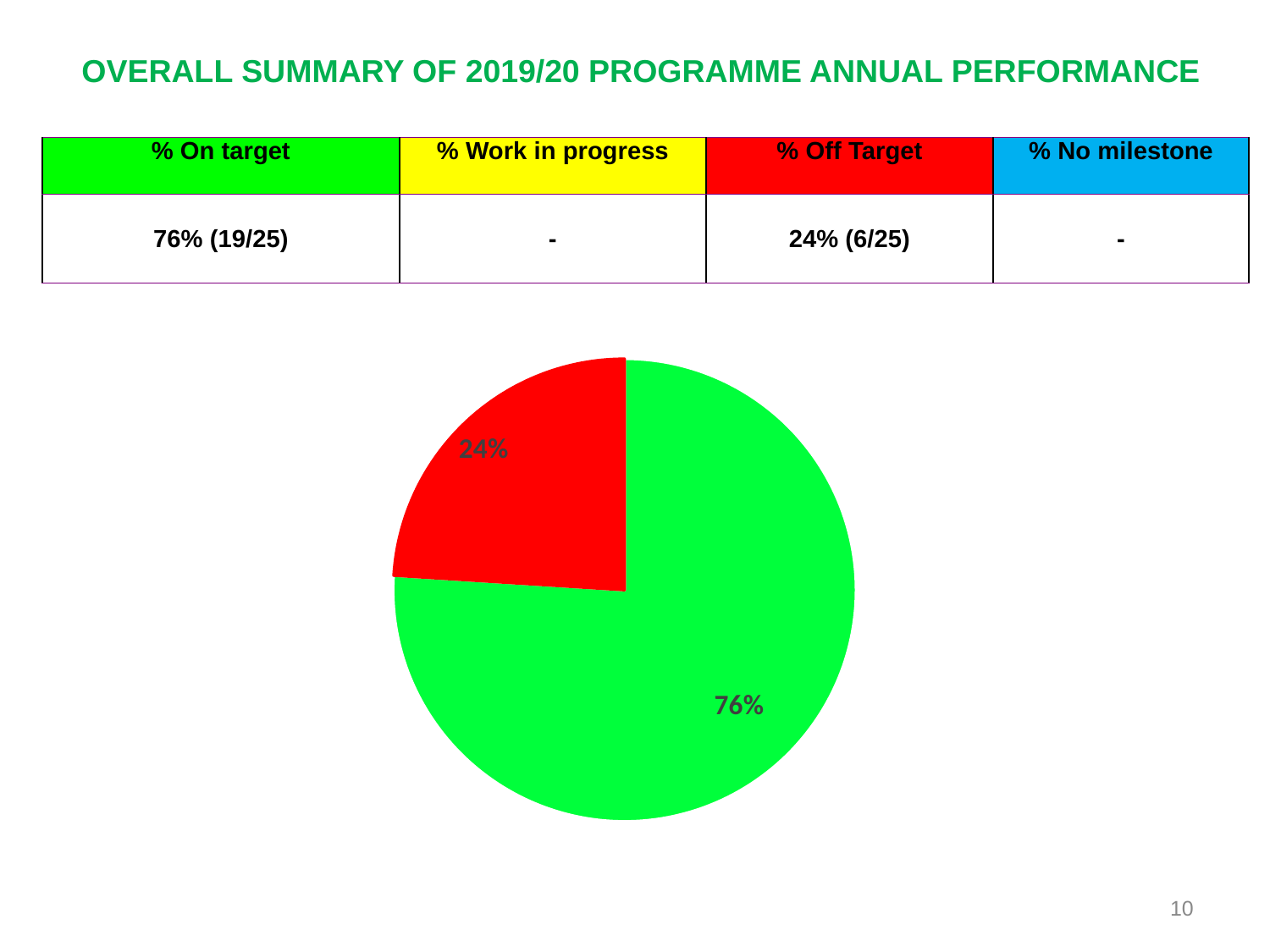
What colour is the slice labelled 76% in the pie chart? green What percentage is shown on the red slice of the pie chart? 24% How many slices does the pie chart have? 2 What share of the pie does the red slice represent? 24% Which slice of the pie chart is the largest? the green slice (76%) What percentage is shown on the green slice of the pie chart? 76% What kind of chart is shown on the slide? pie chart Is the green slice or the red slice of the pie chart larger? the green slice What is the title of the slide containing the pie chart? OVERALL SUMMARY OF 2019/20 PROGRAMME ANNUAL PERFORMANCE Which slice of the pie chart is the smallest? the red slice (24%) What is the difference in percentage points between the green slice and the red slice of the pie chart? 52